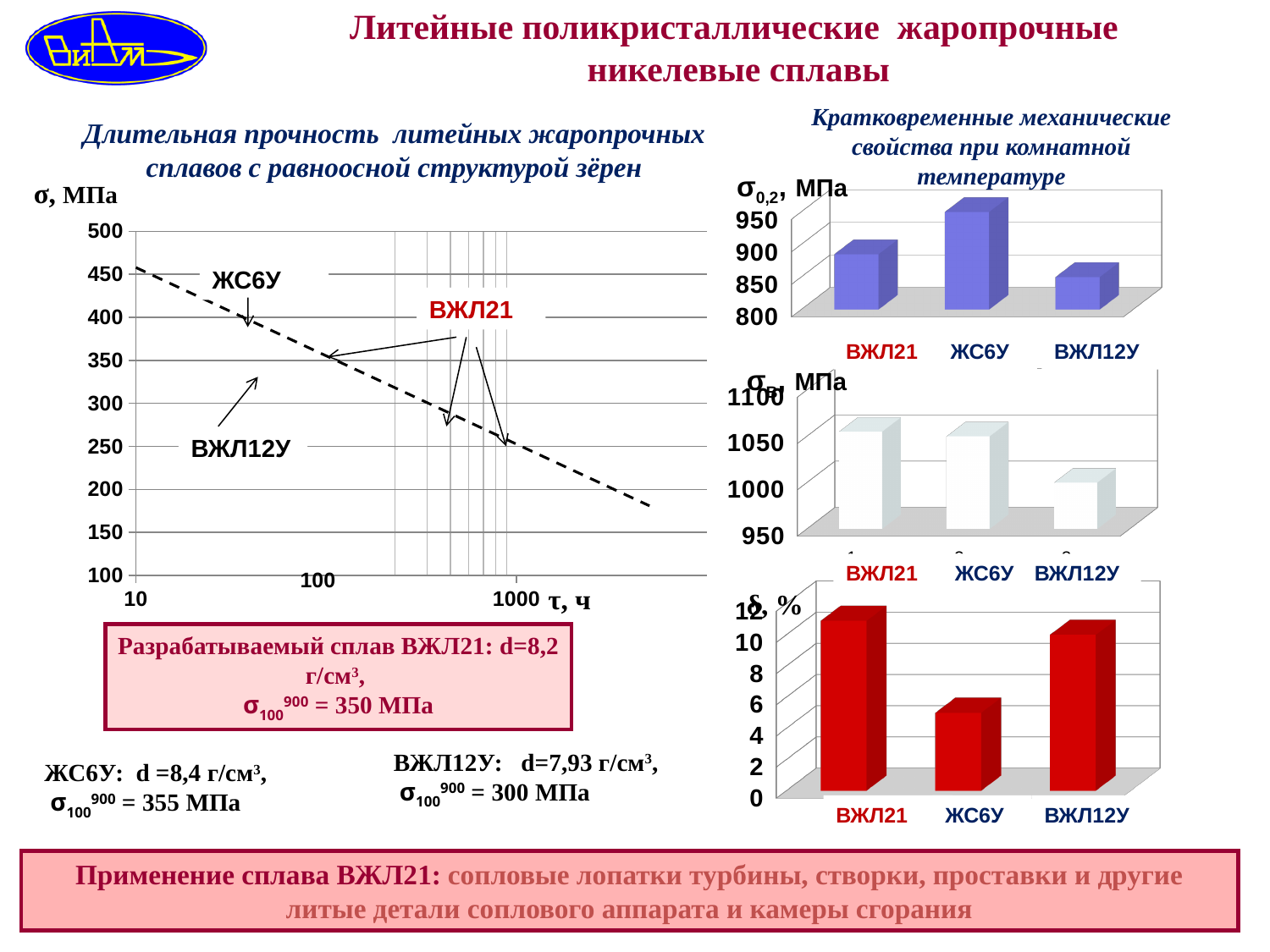
In the σ0,2, МПа chart, which alloy has the highest value? ЖС6У In the δ, % chart, is the value for ЖС6У greater or less than 6? less In the σ0,2, МПа chart, is the value for ВЖЛ12У greater or less than 900? less In the σ0,2, МПа chart, which alloy has the lowest value? ВЖЛ12У In the σв, МПа chart, which alloy has the lowest value? ВЖЛ12У In the σв, МПа chart, is the value for ВЖЛ12У greater or less than 1050? less In the δ, % chart, which alloy has the lowest value? ЖС6У In the chart titled 'Длительная прочность литейных жаропрочных сплавов с равноосной структурой зёрен', does the dashed line rise or fall as τ increases? fall In the δ, % chart, which is larger, the value for ВЖЛ21 or the value for ЖС6У? ВЖЛ21 How many alloys are shown in the δ, % chart? 3 In the δ, % chart, which alloy has the highest value? ВЖЛ21